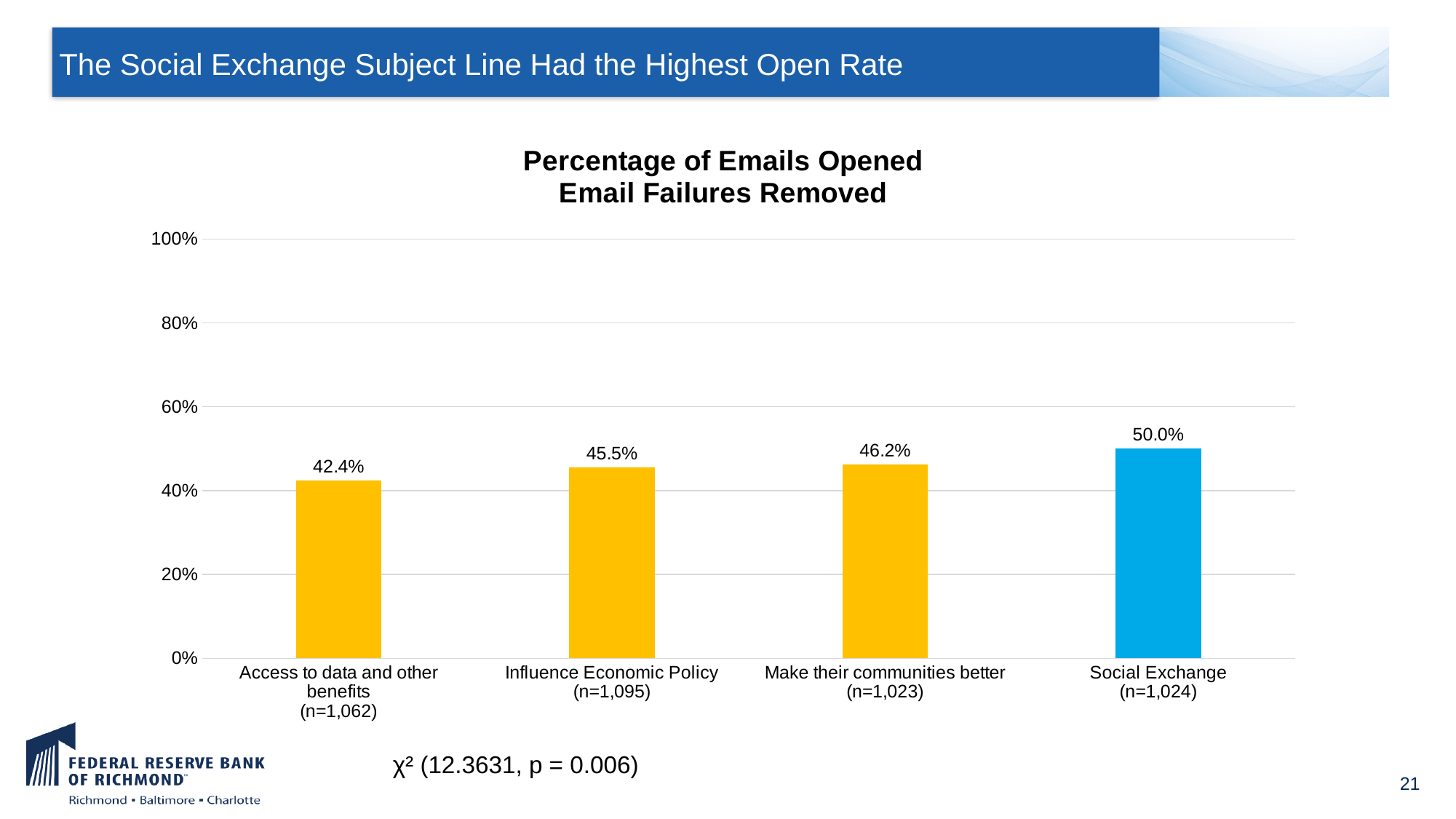
Which subject line had the highest percentage of emails opened? Social Exchange Which subject line had the lowest percentage of emails opened? Access to data and other benefits Which had a higher open rate, Influence Economic Policy or Social Exchange? Social Exchange What is the percentage of emails opened for the Social Exchange subject line? 50.0% What is the percentage of emails opened for the Access to data and other benefits subject line? 42.4% Which bar is shown in a different colour (blue) from the others? Social Exchange What type of chart is shown on the slide? Bar chart How many subject line categories are shown in the chart? 4 Is the open rate for Make their communities better greater or less than 40%? greater What is the difference in open rate between Social Exchange and Access to data and other benefits? 7.6% What is the percentage of emails opened for the Influence Economic Policy subject line? 45.5% What is the difference in open rate between Make their communities better and Influence Economic Policy? 0.7%